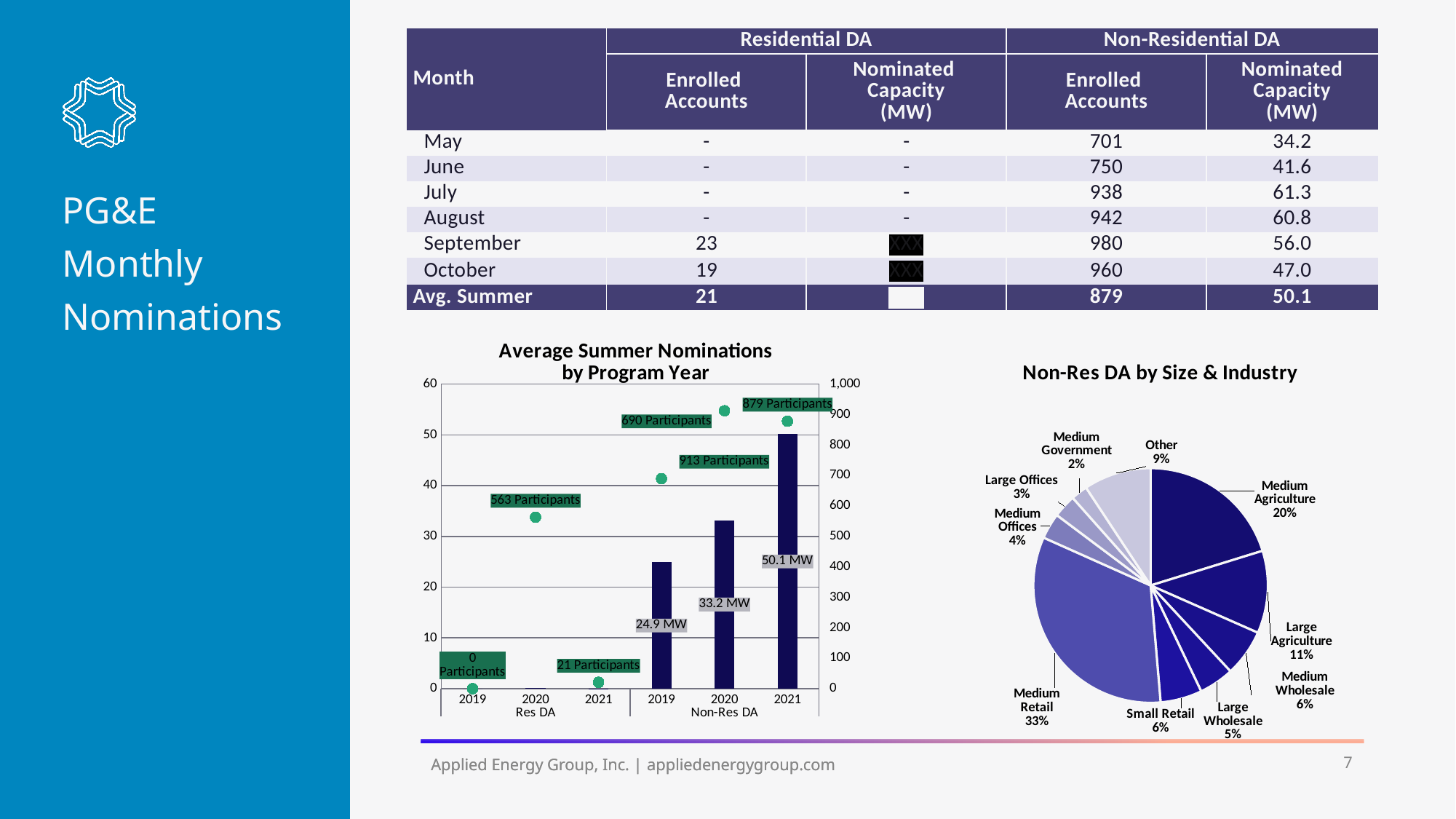
What type of chart is 'Non-Res DA by Size & Industry'? pie chart In the 'Average Summer Nominations by Program Year' chart, what is the difference in MW between Non-Res DA 2021 and Non-Res DA 2020? 16.9 MW In the 'Average Summer Nominations by Program Year' chart, do the Non-Res DA MW bars rise or fall from 2019 to 2021? rise In the 'Non-Res DA by Size & Industry' pie chart, which category has the smallest share? Medium Government In the 'Average Summer Nominations by Program Year' chart, how many participants are shown for Res DA in 2021? 21 Participants How many slices does the 'Non-Res DA by Size & Industry' pie chart have? 10 In the 'Average Summer Nominations by Program Year' chart, which Non-Res DA year has the highest nominated capacity in MW? 2021 In the 'Average Summer Nominations by Program Year' chart, is the Non-Res DA 2020 bar greater or less than 30 on the left axis? greater In the 'Average Summer Nominations by Program Year' chart, what is the nominated capacity for Non-Res DA in 2021? 50.1 MW In the 'Non-Res DA by Size & Industry' pie chart, what share is Medium Retail? 33% In the 'Average Summer Nominations by Program Year' chart, what is the nominated capacity for Non-Res DA in 2019? 24.9 MW In the 'Non-Res DA by Size & Industry' pie chart, which is larger, Medium Agriculture or Large Agriculture? Medium Agriculture